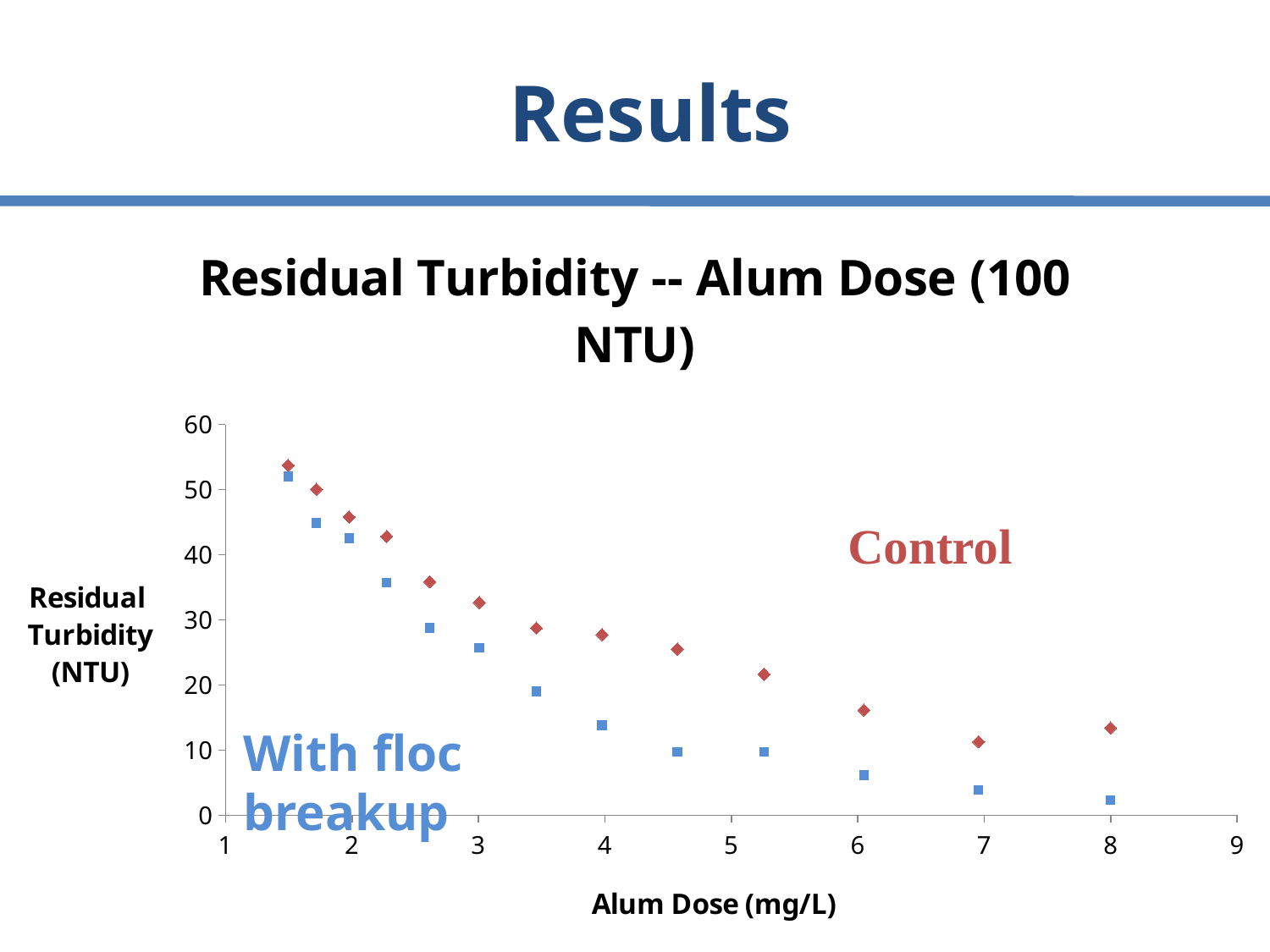
How many data points are plotted for the Control series? 13 What is the label of the x axis? Alum Dose (mg/L) Is the With floc breakup residual turbidity at an alum dose of 4 mg/L greater or less than 20? less How do residual turbidity values change as alum dose increases? They fall Is the Control residual turbidity at an alum dose of 4 mg/L greater or less than 20? greater Is the Control residual turbidity at an alum dose of 8 mg/L greater or less than 10? greater What kind of chart is shown on the slide? Scatter chart How many data series are plotted on the chart? 2 Which series generally shows lower residual turbidity across the alum doses? With floc breakup Which series has the higher residual turbidity at an alum dose of 8 mg/L, Control or With floc breakup? Control What is the title of the chart? Residual Turbidity -- Alum Dose (100 NTU)